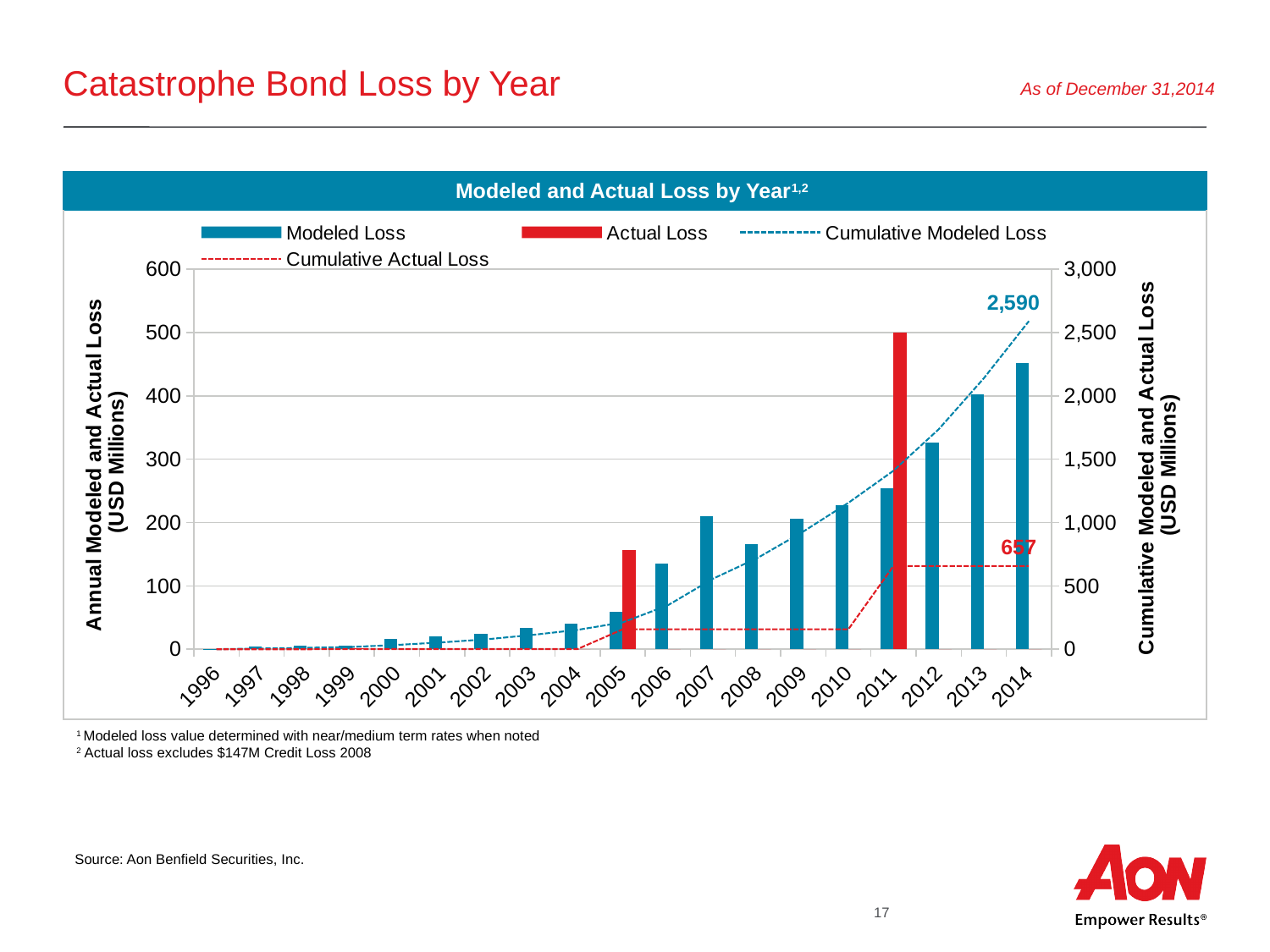
Which year has the highest Modeled Loss bar? 2014 Is the Modeled Loss for 2014 greater or less than 400? greater What kind of chart is used for the Modeled Loss and Actual Loss series? bar chart How many years are shown on the x axis? 19 What is the labeled value of the Cumulative Modeled Loss in 2014? 2,590 Is the Modeled Loss for 2006 greater or less than 200? less How many series does the legend list? 4 What is the difference between the labeled Cumulative Modeled Loss and Cumulative Actual Loss in 2014? 1,933 Does the Modeled Loss rise or fall from 2010 to 2014? rise What is the labeled value of the Cumulative Actual Loss in 2014? 657 Is the Actual Loss for 2011 greater or less than 400? greater Which year has the larger Actual Loss bar, 2005 or 2011? 2011